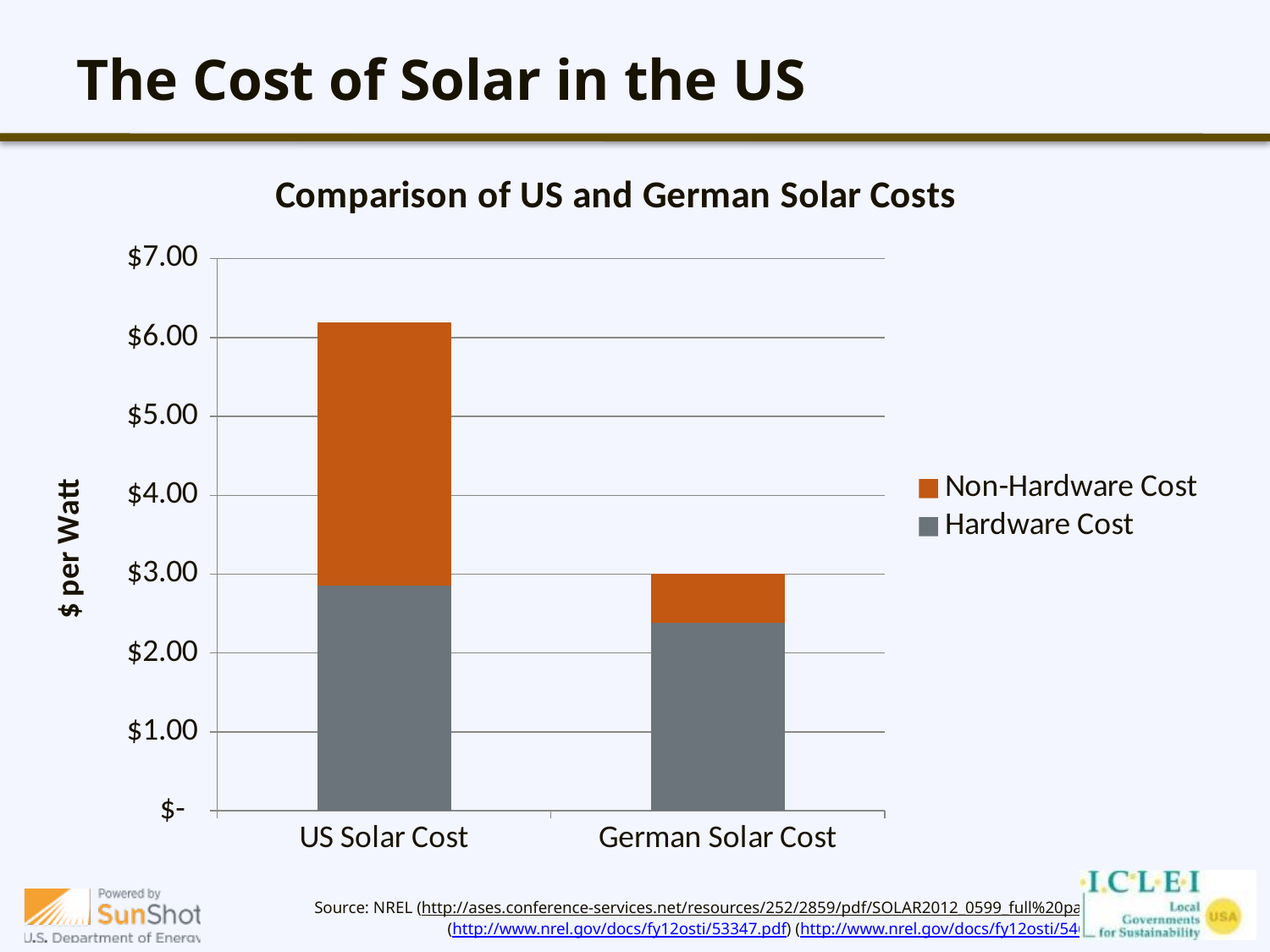
Which category has the lowest total cost? German Solar Cost Which category has the higher total cost, US Solar Cost or German Solar Cost? US Solar Cost What kind of chart is shown on the slide? stacked bar chart Is the Hardware Cost for German Solar Cost greater or less than $3.00? less Is the total value for US Solar Cost greater or less than $6.00? greater What is the label on the y axis? $ per Watt How many series does the legend list? 2 How many categories are shown on the x axis? 2 What is the title of the chart? Comparison of US and German Solar Costs Is the total value for German Solar Cost greater or less than $4.00? less Which category has the larger Non-Hardware Cost segment, US Solar Cost or German Solar Cost? US Solar Cost